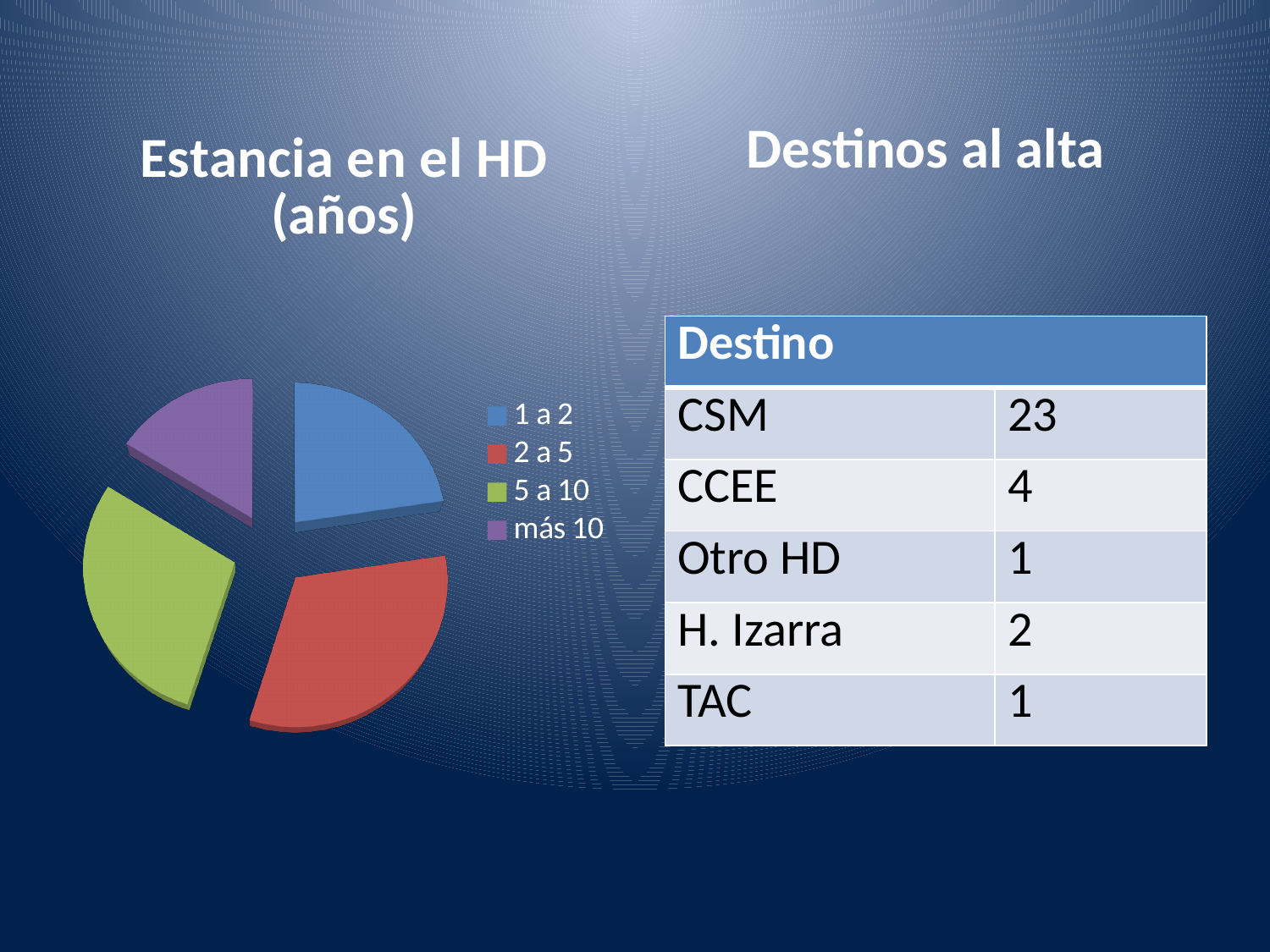
In the "Estancia en el HD (años)" pie chart, which slice is larger, "2 a 5" or "más 10"? 2 a 5 What colour is the "1 a 2" slice in the "Estancia en el HD (años)" pie chart? blue What is the title of the pie chart on the slide? Estancia en el HD (años) In the "Estancia en el HD (años)" pie chart, which slice is larger, "2 a 5" or "1 a 2"? 2 a 5 In the "Estancia en el HD (años)" pie chart, which slice is larger, "5 a 10" or "más 10"? 5 a 10 How many entries does the legend of the "Estancia en el HD (años)" pie chart list? 4 Which category has the largest slice in the "Estancia en el HD (años)" pie chart? 2 a 5 What kind of chart is shown under the title "Estancia en el HD (años)"? pie chart How many slices does the "Estancia en el HD (años)" pie chart have? 4